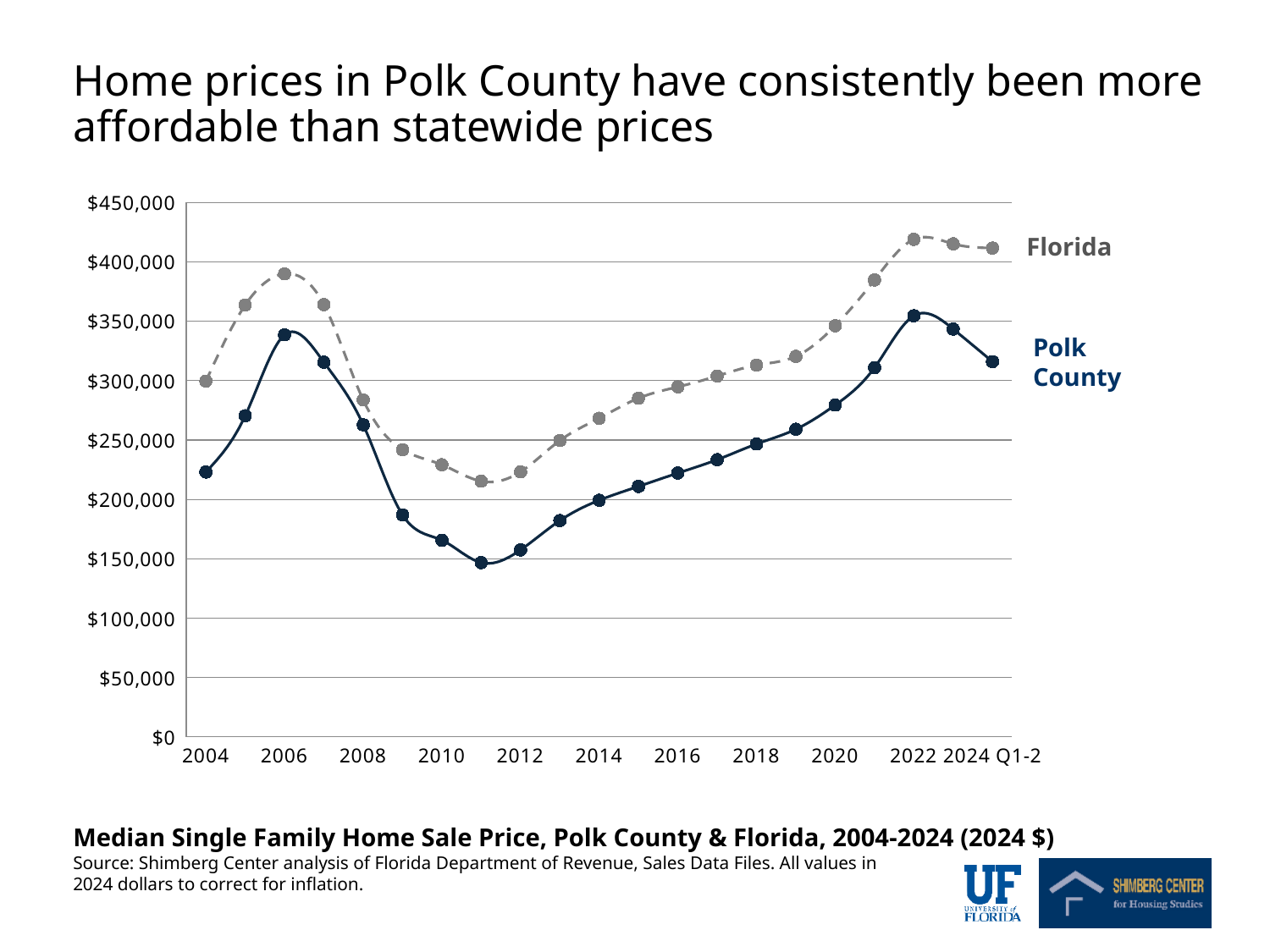
How many series does the chart plot? 2 Which series is drawn with a dashed gray line? Florida What kind of chart is shown on the slide? line chart Does the Polk County series rise or fall between 2011 and 2022? rise In which year does the Florida series reach its highest value? 2022 Is the Florida value for 2022 greater or less than $400,000? greater In which year does the Polk County series reach its lowest value? 2011 Is the Polk County value for 2020 greater or less than $250,000? greater Is the Polk County value for 2006 greater or less than $350,000? less In which year does the Polk County series reach its highest value? 2022 Which series has the larger value in 2006, Florida or Polk County? Florida